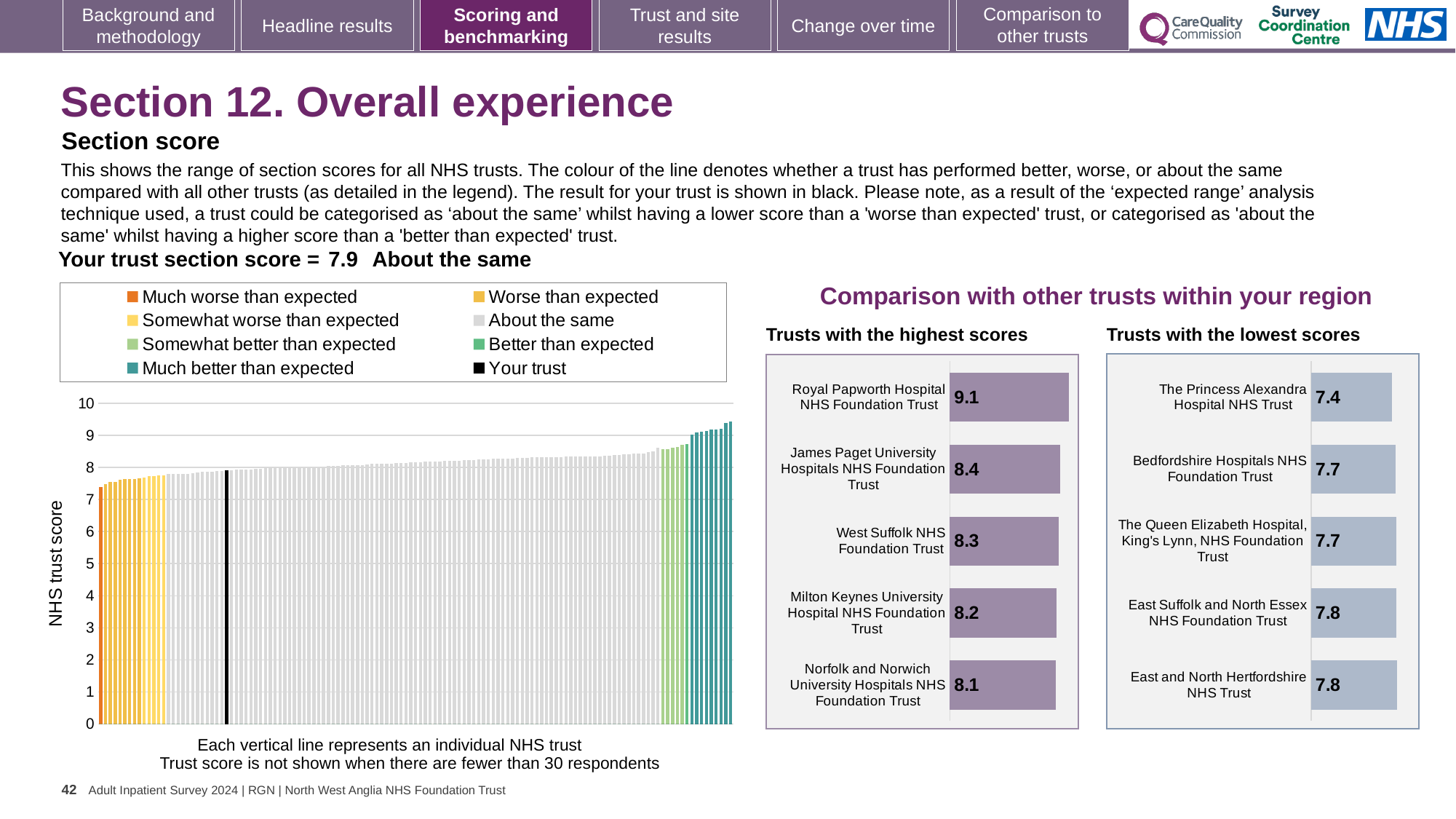
How many entries does the legend of the main 'NHS trust score' chart list? 8 In the 'Trusts with the highest scores' chart, what is the score for Royal Papworth Hospital NHS Foundation Trust? 9.1 How many trusts are shown in the 'Trusts with the highest scores' chart? 5 In the 'Trusts with the lowest scores' chart, what is the difference between the scores of Bedfordshire Hospitals NHS Foundation Trust and The Princess Alexandra Hospital NHS Trust? 0.3 In the 'Trusts with the highest scores' chart, which has the higher score: James Paget University Hospitals NHS Foundation Trust or West Suffolk NHS Foundation Trust? James Paget University Hospitals NHS Foundation Trust In the 'Trusts with the highest scores' chart, what is the difference between the scores of Royal Papworth Hospital NHS Foundation Trust and Norfolk and Norwich University Hospitals NHS Foundation Trust? 1.0 In the 'Trusts with the lowest scores' chart, which trust has the lowest score? The Princess Alexandra Hospital NHS Trust What is the y-axis label of the main chart showing each individual NHS trust? NHS trust score What kind of chart is the 'Trusts with the lowest scores' chart? Bar chart In the 'Trusts with the lowest scores' chart, what is the score for East Suffolk and North Essex NHS Foundation Trust? 7.8 In the 'Trusts with the highest scores' chart, which trust has the highest score? Royal Papworth Hospital NHS Foundation Trust In the main 'NHS trust score' chart, what is the section score for your trust (the black line)? 7.9